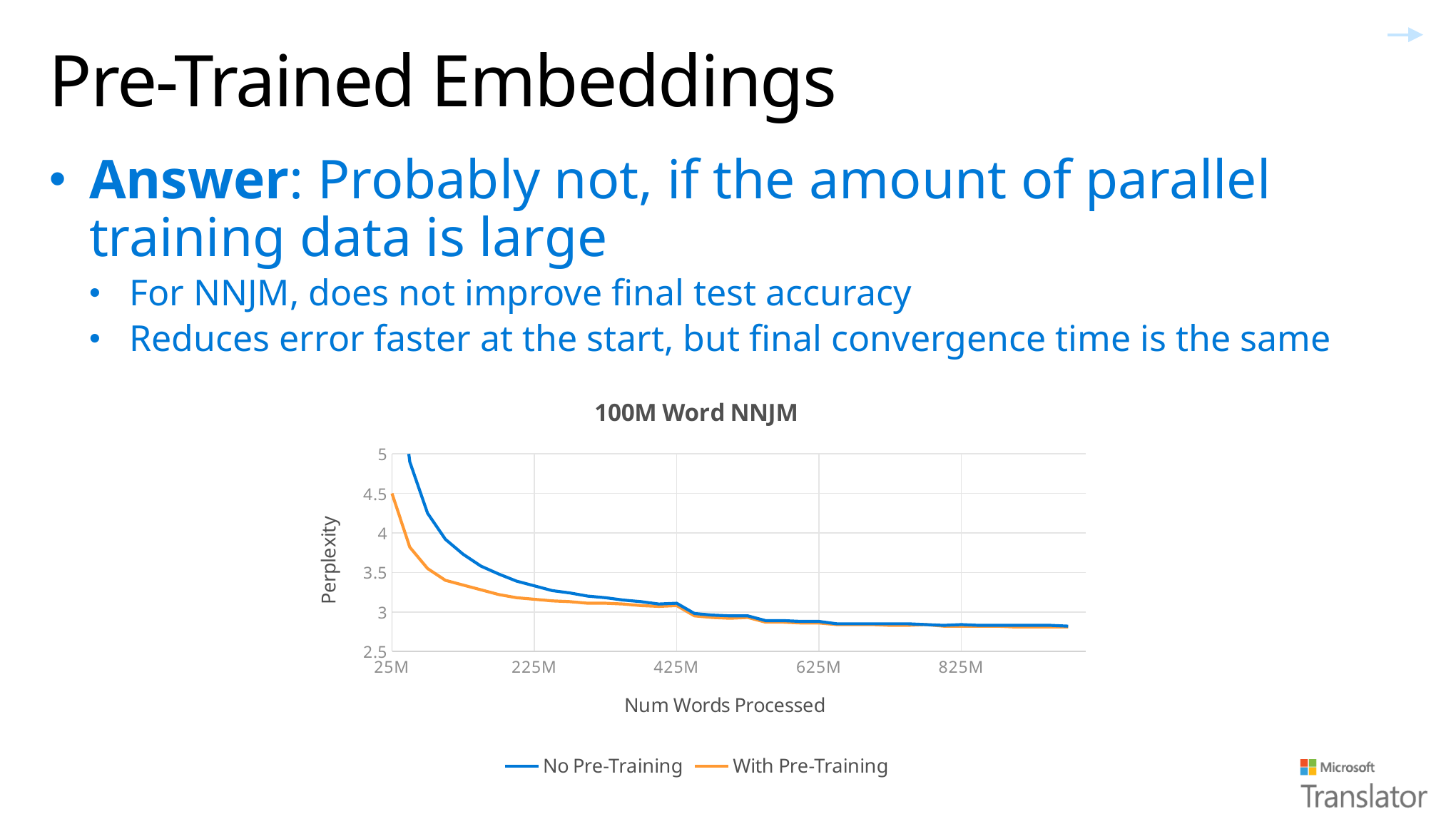
How many series does the legend of the chart list? 2 Is the perplexity for With Pre-Training at 225M words processed greater or less than 3.5? less What is the title of the chart? 100M Word NNJM Which series starts with the higher perplexity at the left of the chart? No Pre-Training At 225M words processed, which series has the higher perplexity, No Pre-Training or With Pre-Training? No Pre-Training Is the perplexity for No Pre-Training at 25M words processed greater or less than 4.5? greater What is the label of the y axis of the chart? Perplexity What kind of chart is shown on the slide? line chart Do the perplexity values rise or fall as the number of words processed increases? fall Is the perplexity for No Pre-Training at 625M words processed greater or less than 3? less